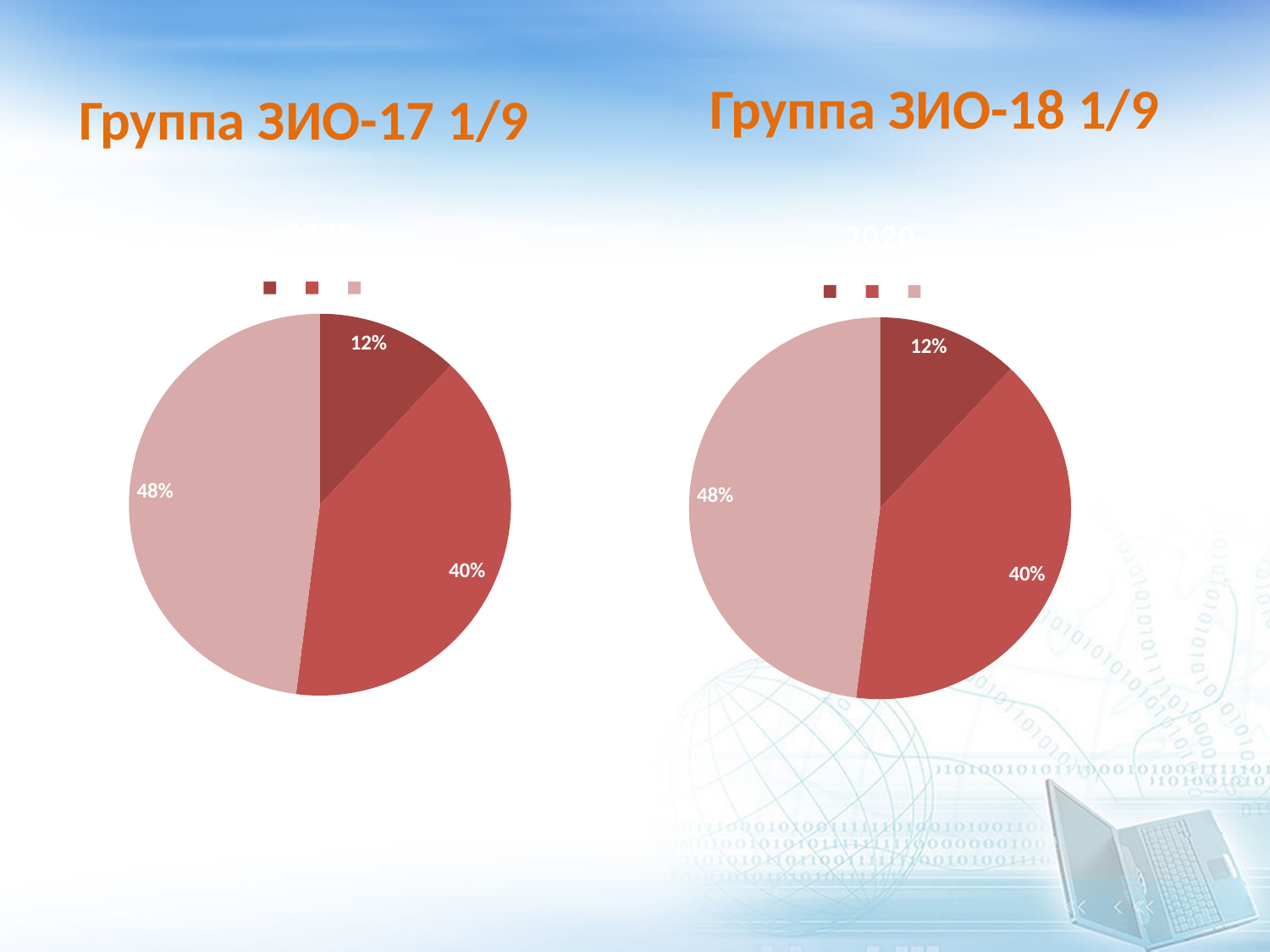
In the pie chart under "Группа ЗИО-17 1/9", what percentage is shown for the largest slice? 48% What kind of chart is shown under the heading "Группа ЗИО-17 1/9"? pie chart In the pie chart under "Группа ЗИО-18 1/9", what share does the light pink slice have? 48% In the pie chart under "Группа ЗИО-18 1/9", what is the difference between the largest slice and the smallest slice? 36% In the pie chart under "Группа ЗИО-17 1/9", what share does the darkest red slice have? 12% In the pie chart under "Группа ЗИО-17 1/9", what is the difference between the 48% slice and the 40% slice? 8% In the pie chart under "Группа ЗИО-17 1/9", what share does the medium red slice have? 40% How many entries does the legend of the pie chart under "Группа ЗИО-17 1/9" list? 3 In the pie chart under "Группа ЗИО-18 1/9", what percentage is shown for the smallest slice? 12% How many slices does the pie chart under "Группа ЗИО-18 1/9" have? 3 Do the two pie charts on the slide show the same set of percentages? yes In the pie chart under "Группа ЗИО-18 1/9", which slice is larger: the light pink slice or the medium red slice? the light pink slice